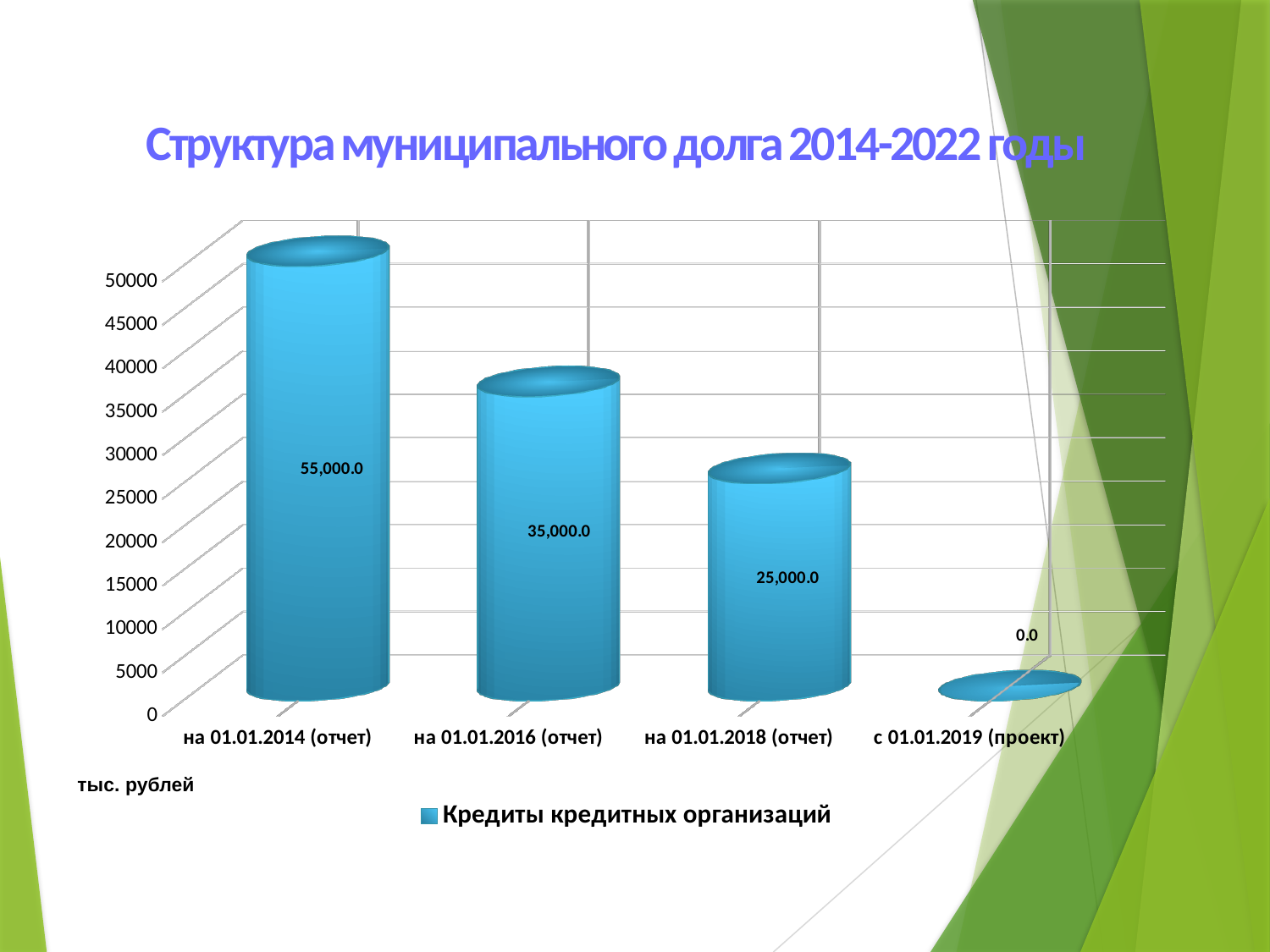
Which category has the highest value? на 01.01.2014 (отчет) How many series does the legend list? 1 What is the value for "на 01.01.2016 (отчет)"? 35,000.0 What is the value for "на 01.01.2018 (отчет)"? 25,000.0 Do the values rise or fall from left to right along the x axis? Fall What is the difference between the values for "на 01.01.2014 (отчет)" and "на 01.01.2016 (отчет)"? 20,000.0 Which is larger, the value for "на 01.01.2016 (отчет)" or "на 01.01.2018 (отчет)"? на 01.01.2016 (отчет) What is the value for "с 01.01.2019 (проект)"? 0.0 Which category has the lowest value? с 01.01.2019 (проект) What kind of chart is shown on the slide? Bar chart How many categories are shown on the x axis? 4 What is the value for "на 01.01.2014 (отчет)"? 55,000.0